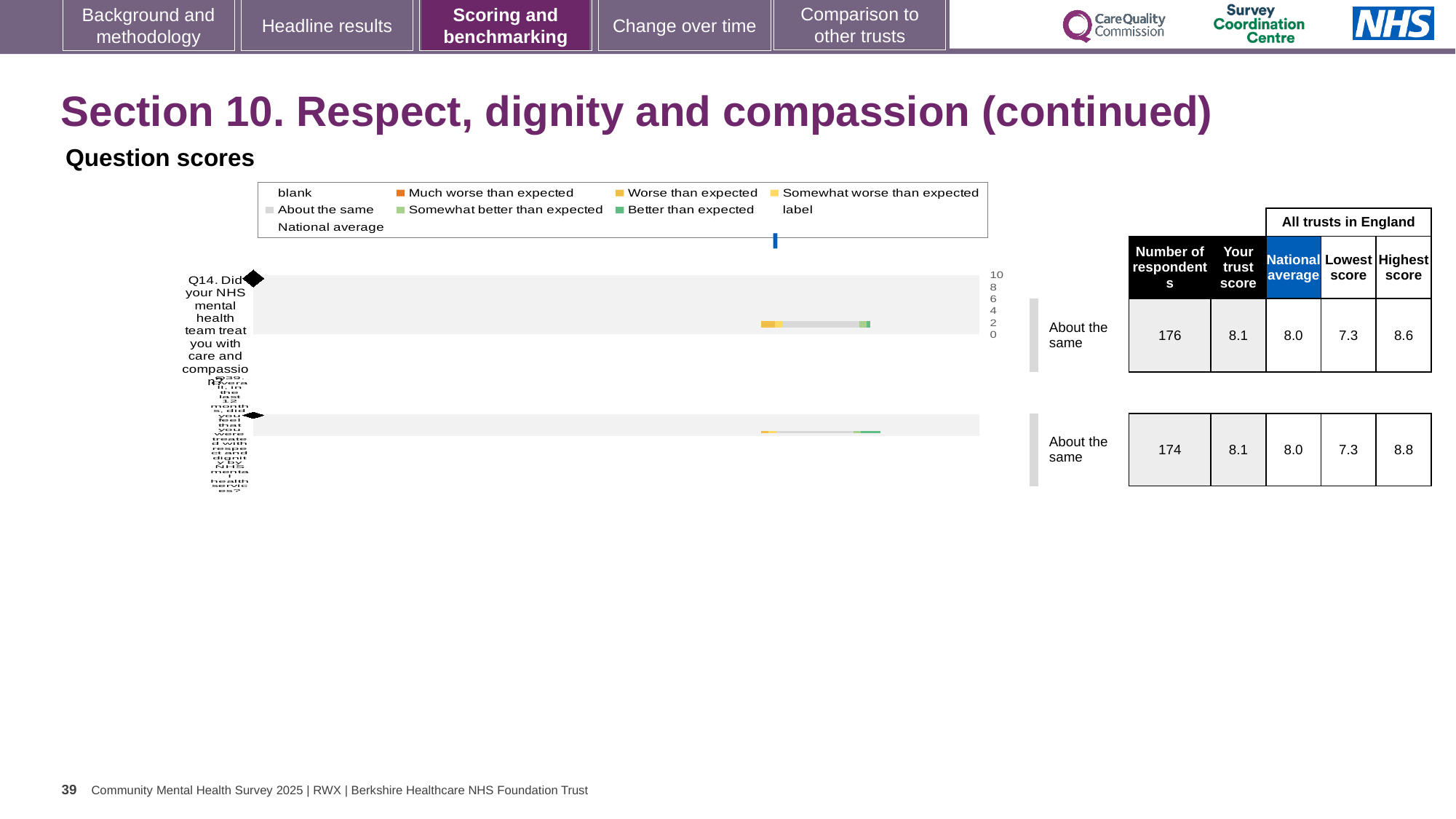
What is the highest score among all trusts in England for Q39? 8.8 What is the difference between the trust score and the national average for Q14? 0.1 What is the highest score among all trusts in England for Q14? 8.6 How many questions are plotted on the chart? 2 Which is larger for Q14, the trust score or the national average? the trust score What is the difference between the highest score for Q39 and the highest score for Q14? 0.2 What is the maximum value shown on the chart's score axis? 10 What is the national average for Q14? 8.0 What is the number of respondents for Q39? 174 What is the trust score for Q14? 8.1 What kind of chart is used to show the question scores? bar chart What is the number of respondents for Q14? 176